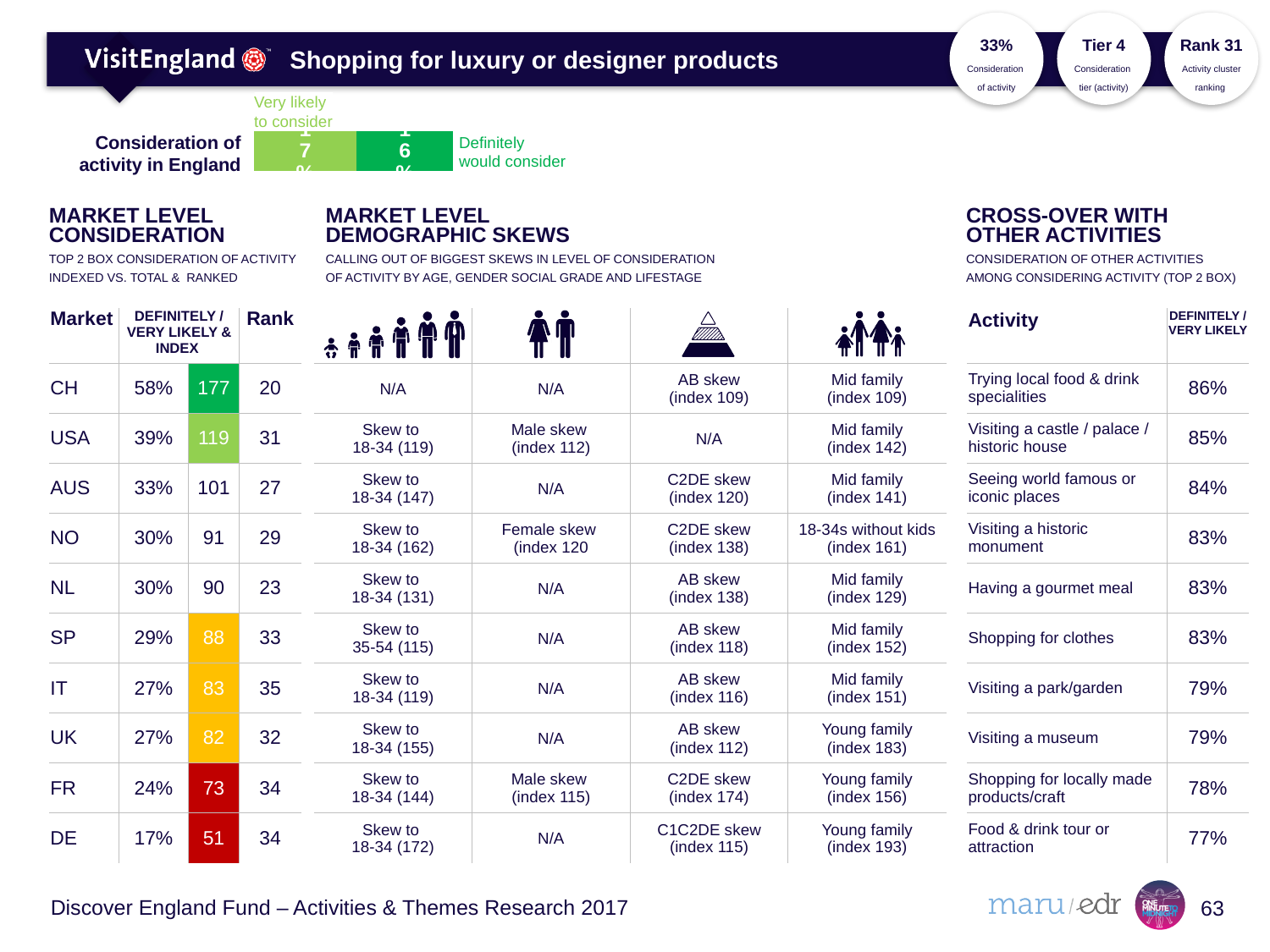
How many segments (series) does the 'Consideration of activity in England' bar have? 2 In the 'Consideration of activity in England' chart, what is the value for 'Definitely would consider'? 16% In the 'Consideration of activity in England' chart, what is the value for 'Very likely to consider'? 17% In the 'Consideration of activity in England' chart, which segment is larger: 'Very likely to consider' or 'Definitely would consider'? Very likely to consider In the 'Consideration of activity in England' chart, which segment is shown in the lighter green? Very likely to consider In the 'Consideration of activity in England' chart, what is the difference between 'Very likely to consider' and 'Definitely would consider'? 1% What kind of chart is the 'Consideration of activity in England' chart? bar chart What is the total of the 'Consideration of activity in England' stacked bar? 33% In the 'Consideration of activity in England' chart, which segment is shown in the darker green? Definitely would consider